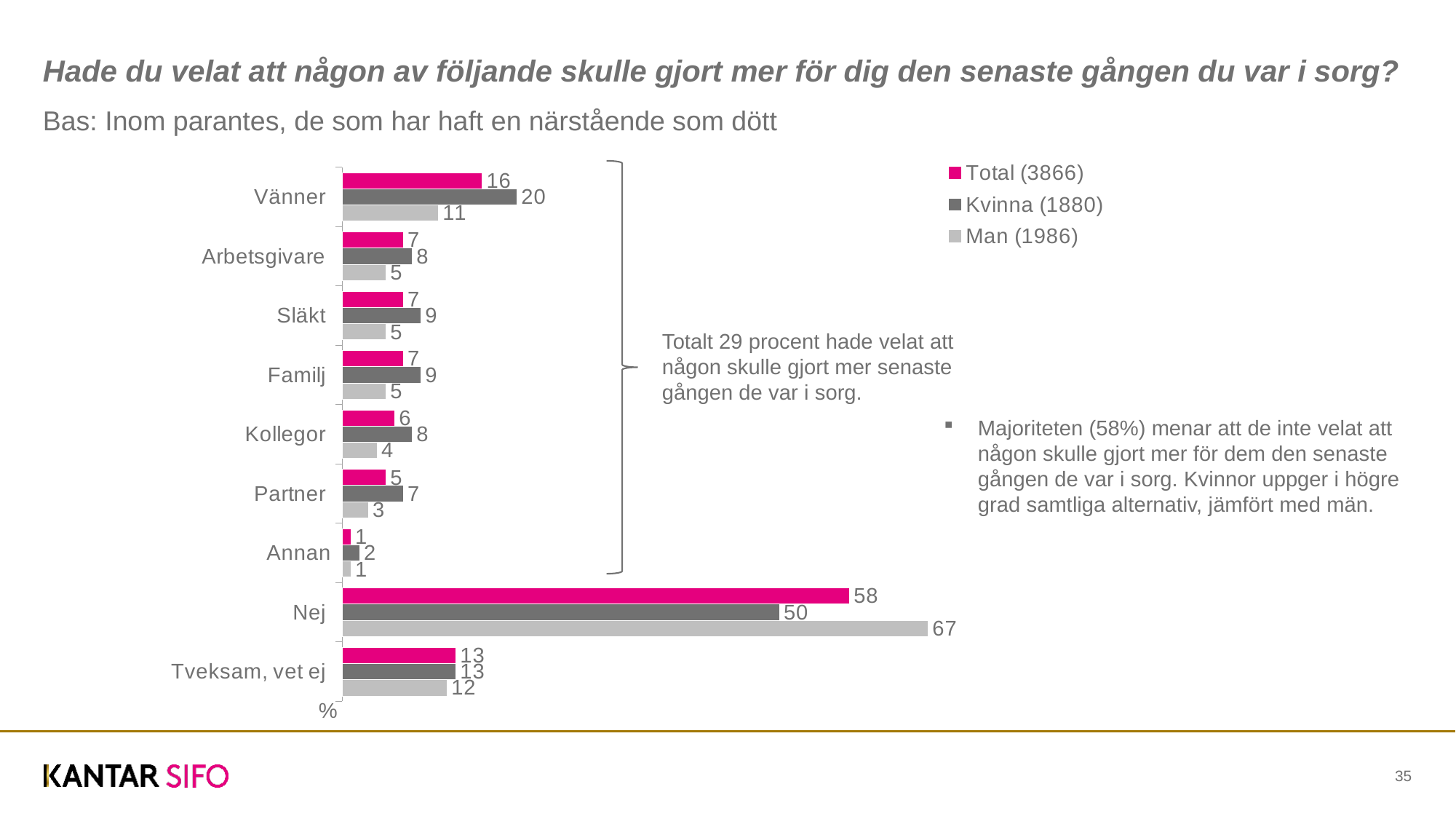
How many categories are shown on the chart? 9 What is the value for Partner in the Total (3866) series? 5 What is the difference between the Kvinna (1880) and Man (1986) values for Vänner? 9 What is the value for Nej in the Man (1986) series? 67 What kind of chart is shown on the slide? Bar chart Which category has the lowest value in the Kvinna (1880) series? Annan What is the value for Vänner in the Kvinna (1880) series? 20 Which is larger for Kollegor: the Kvinna (1880) value or the Man (1986) value? Kvinna (1880) What is the difference between the Man (1986) and Kvinna (1880) values for Nej? 17 Which colour represents the Total (3866) series? Pink How many series does the legend list? 3 Which category has the highest value in the Total (3866) series? Nej